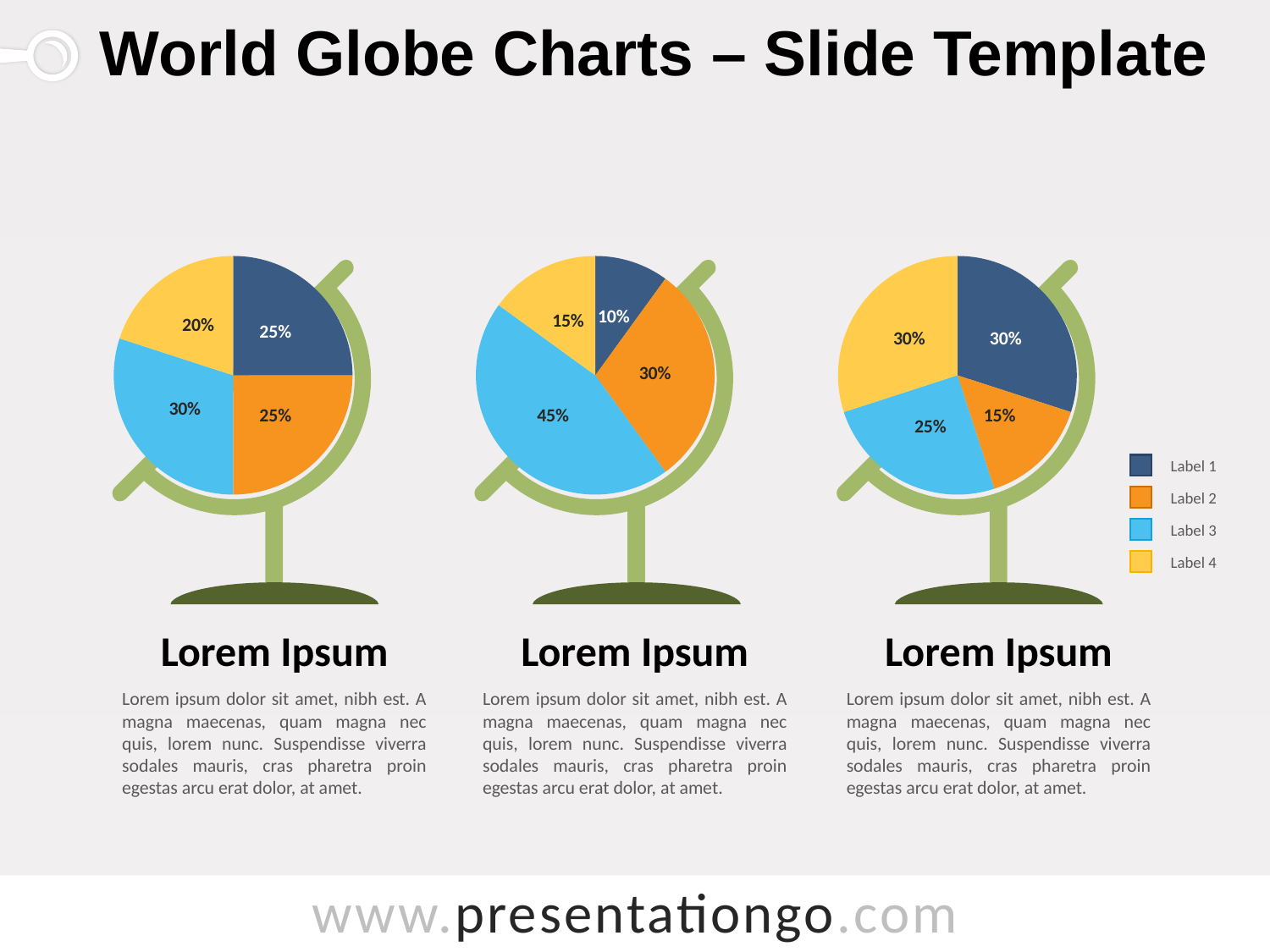
How many entries does the legend on the slide list? 4 In the middle pie chart, which label has the smallest slice? Label 1 In the right pie chart, what is the value for Label 2? 15% In the middle pie chart, what is the difference between the values for Label 3 and Label 1? 35% In the middle pie chart, which label has the largest slice? Label 3 In the right pie chart, what is the difference between the values for Label 1 and Label 2? 15% In the left pie chart, what is the value for Label 3? 30% How many slices does the left pie chart have? 4 In the middle pie chart, what is the value for Label 2? 30% What kind of chart is the left chart on the slide? pie chart In the right pie chart, which is larger, the slice for Label 3 or the slice for Label 2? Label 3 In the left pie chart, which label has the smallest slice? Label 4